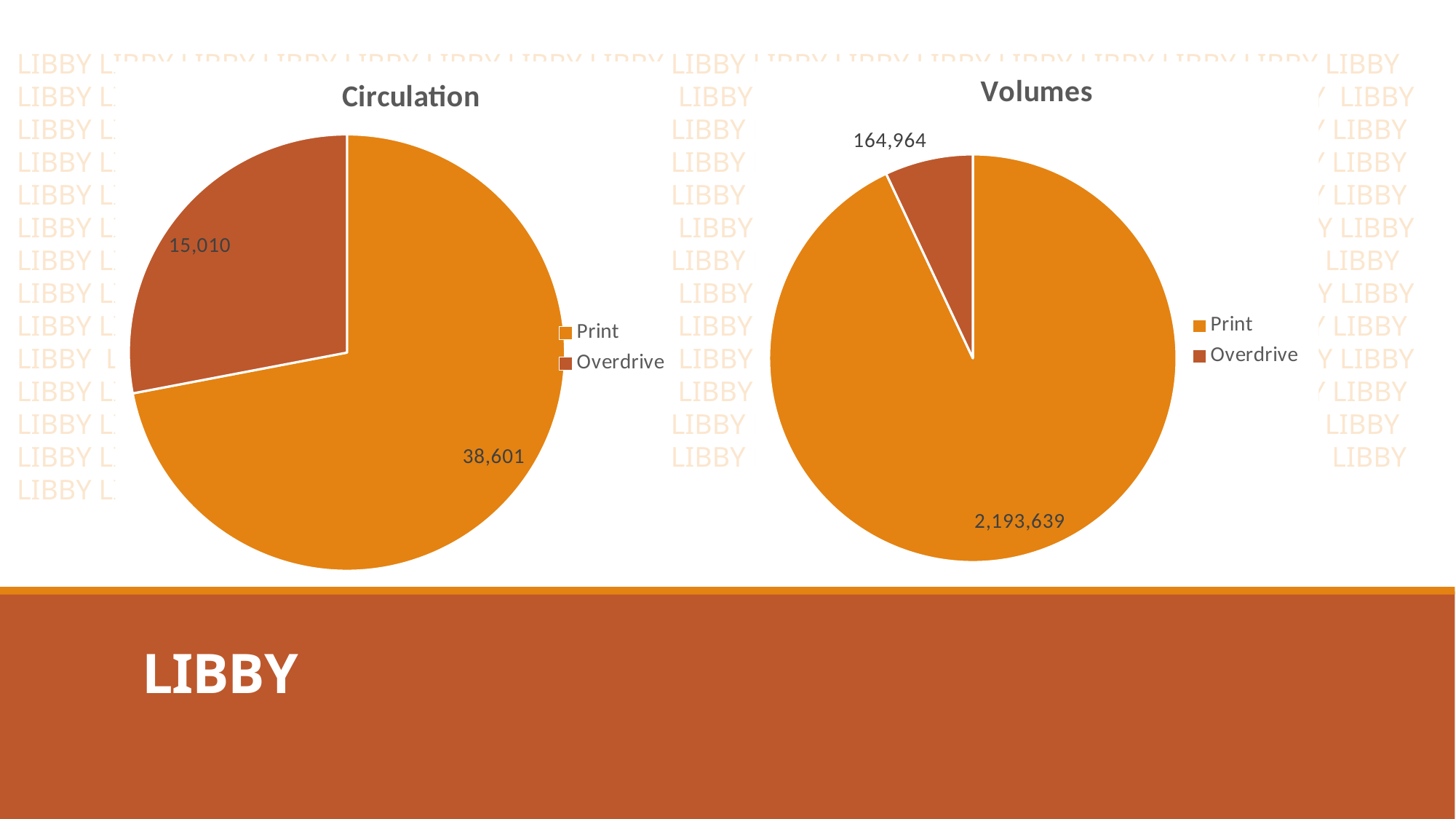
In the Volumes chart, what is the value for Print? 2,193,639 In the Volumes chart, what is the difference between the Print and Overdrive values? 2,028,675 In the Volumes chart, what is the value for Overdrive? 164,964 In the Circulation chart, what is the total of the Print and Overdrive values? 53,611 What type of chart is the Volumes chart? pie chart How many series does the legend of the Circulation chart list? 2 In the Volumes chart, is the value for Print larger or smaller than the value for Overdrive? larger In the Circulation chart, which category has the largest slice? Print In the Circulation chart, what is the value for Overdrive? 15,010 In the Circulation chart, what is the value for Print? 38,601 In the Volumes chart, which category has the smallest slice? Overdrive In the Circulation chart, what is the difference between the Print and Overdrive values? 23,591